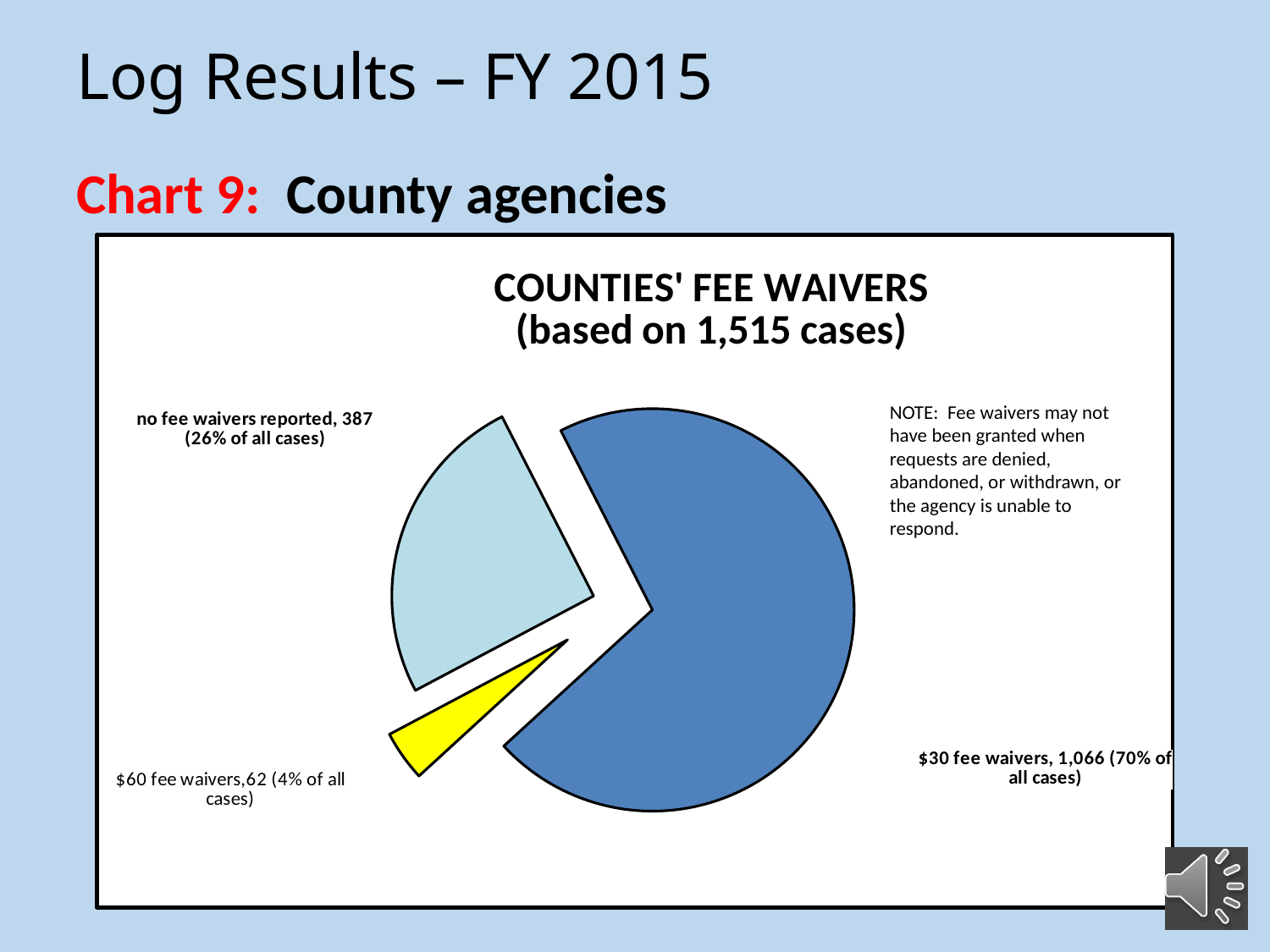
How many cases had $60 fee waivers? 62 How many cases had $30 fee waivers? 1,066 What share of all cases had no fee waivers reported? 26% How many slices does the pie chart have? 3 Which category has the smallest slice of the pie? $60 fee waivers What is the title of the chart? COUNTIES' FEE WAIVERS (based on 1,515 cases) Which category has the largest slice of the pie? $30 fee waivers What is the difference between the number of cases with $30 fee waivers and the number with no fee waivers reported? 679 How many cases had no fee waivers reported? 387 What share of all cases had $60 fee waivers? 4% What share of all cases had $30 fee waivers? 70% What kind of chart is shown on the slide? pie chart